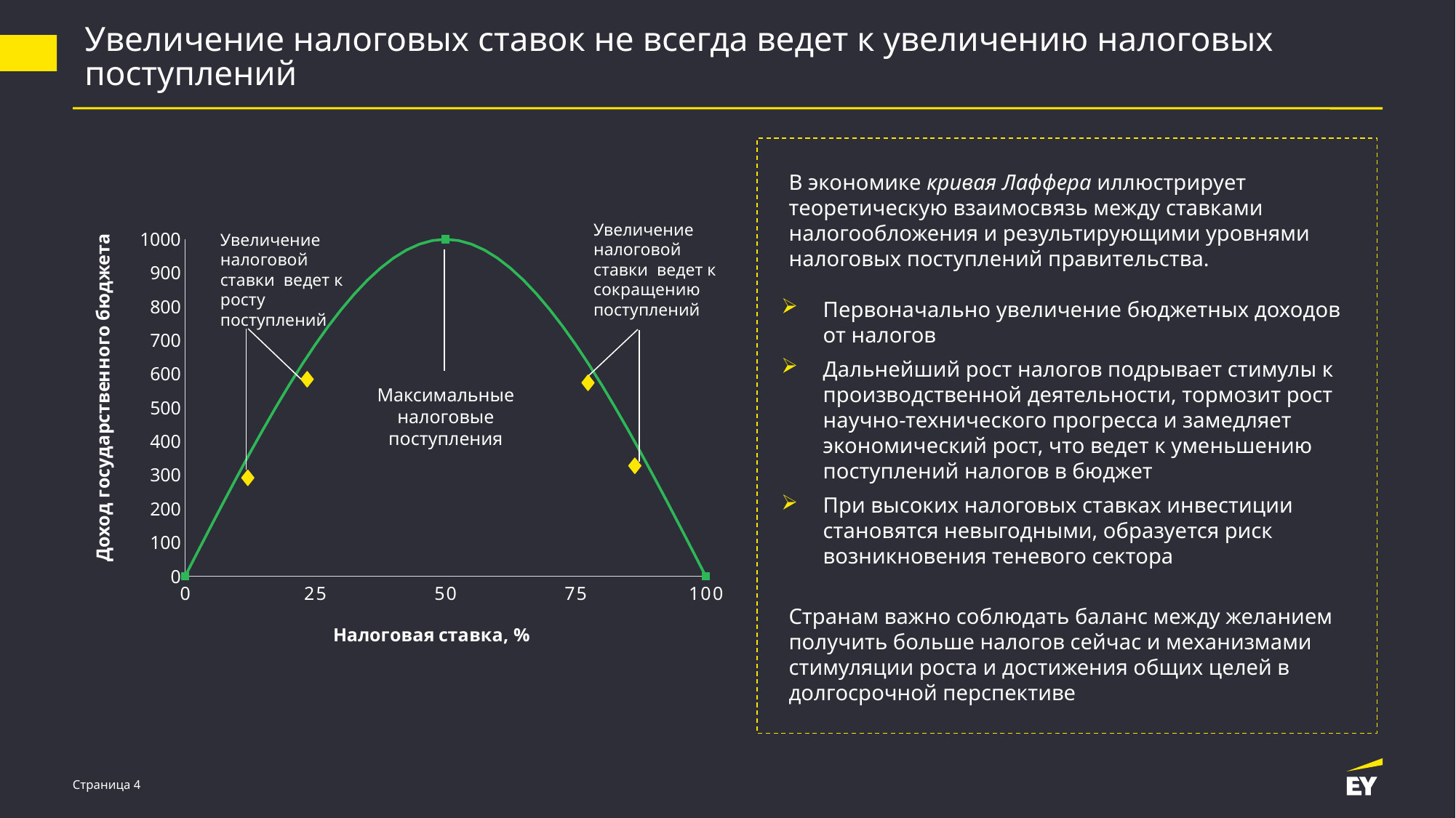
At which tax rate does the curve reach its highest value? 50 Is the value at the yellow diamond marker just below a tax rate of 25% greater or less than 500? greater How does the curve behave as the tax rate increases from 50% to 100%? it falls What is the value of the curve at a tax rate of 50%? 1000 What is the value of the curve at a tax rate of 100%? 0 What is the label of the y axis of the chart? Доход государственного бюджета What is the value of the curve at a tax rate of 0%? 0 Is the value at the last yellow diamond marker (tax rate between 75 and 100) greater or less than 500? less Is the value at the first yellow diamond marker (tax rate just above 10%) greater or less than 400? less How many yellow diamond markers are placed on the curve? 4 What kind of chart is shown on the slide? line chart What is the label of the x axis of the chart? Налоговая ставка, %